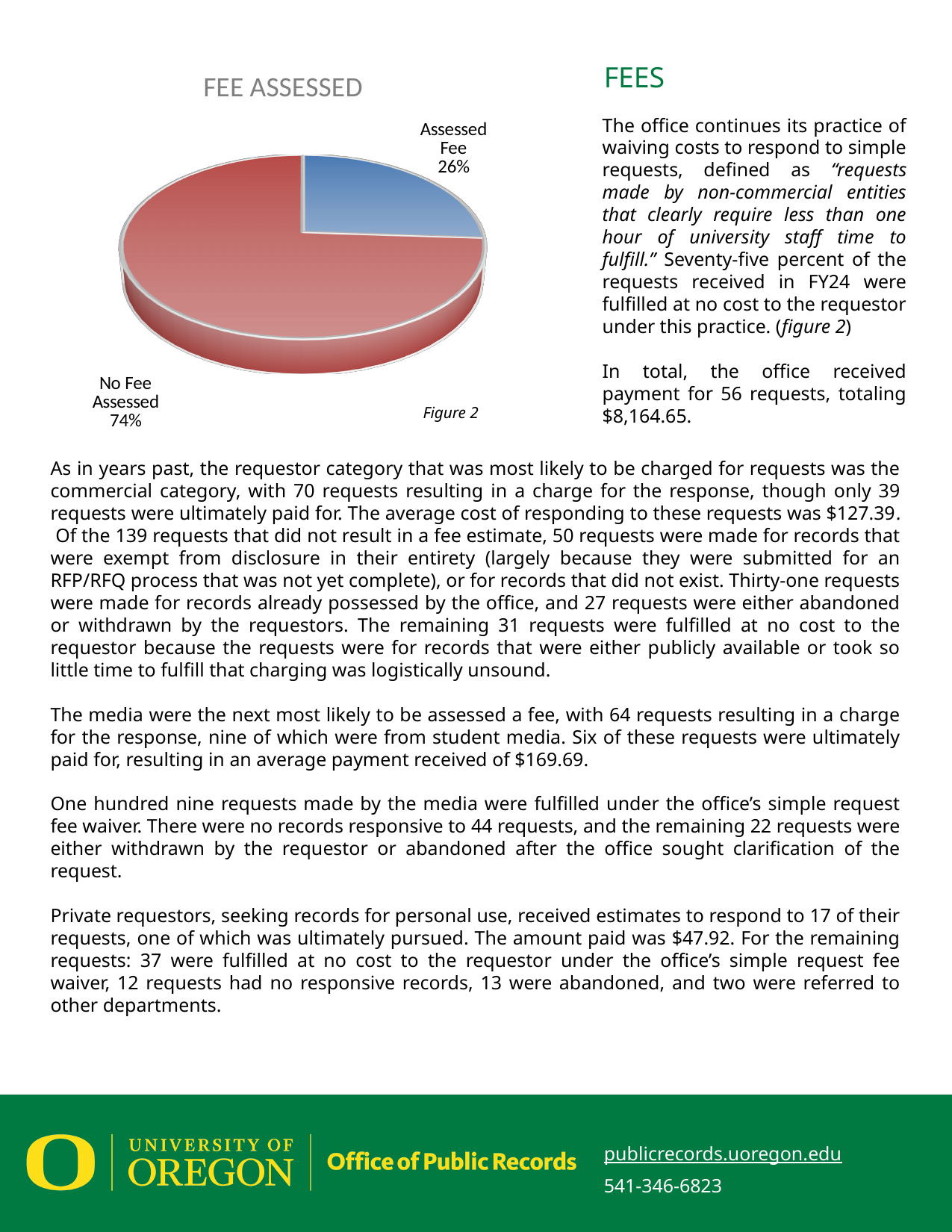
What percentage of requests had an Assessed Fee? 26% What kind of chart is shown on the slide? pie chart Which slice of the pie chart is the largest? No Fee Assessed What colour is the No Fee Assessed slice? red What is the difference in percentage points between No Fee Assessed and Assessed Fee? 48 Which slice of the pie chart is the smallest? Assessed Fee What share of the pie does the Assessed Fee slice represent? 26% What figure number is given for the pie chart? Figure 2 How many slices does the pie chart have? 2 What is the title of the pie chart? FEE ASSESSED Which is larger, the Assessed Fee slice or the No Fee Assessed slice? No Fee Assessed What percentage of requests had No Fee Assessed? 74%